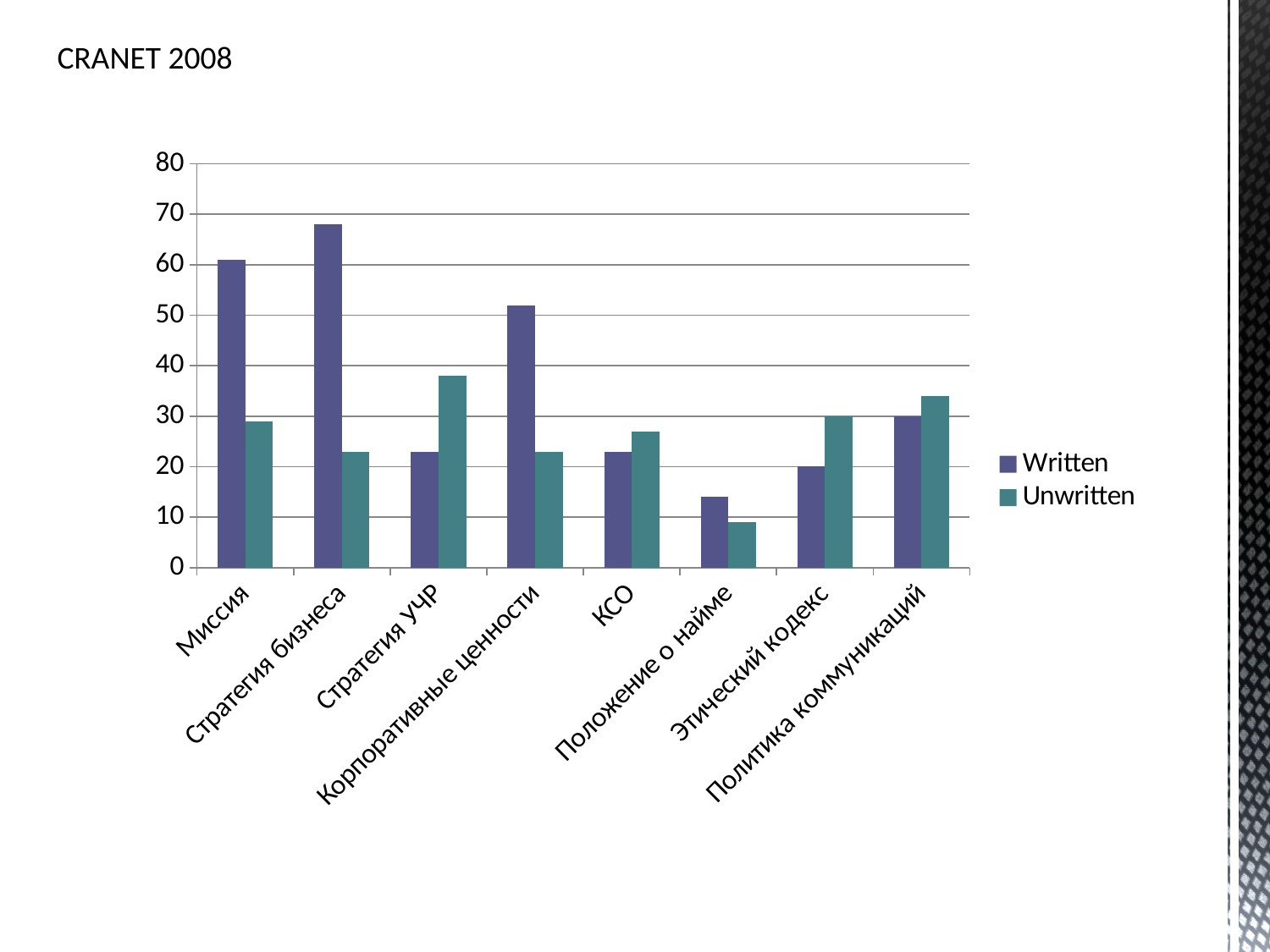
How many categories are shown on the x axis? 8 Is the Unwritten value for Положение о найме greater or less than 20? less Which category has the highest Written value? Стратегия бизнеса How many series does the legend list? 2 What kind of chart is shown on the slide? bar chart Which category has the lowest Written value? Положение о найме Is the Written value for Стратегия бизнеса greater or less than 60? greater What is the title of the slide? CRANET 2008 Which category has the highest Unwritten value? Стратегия УЧР Which category has the lowest Unwritten value? Положение о найме For Миссия, which is larger: the Written or the Unwritten value? Written Is the Unwritten value for Стратегия УЧР greater or less than 30? greater